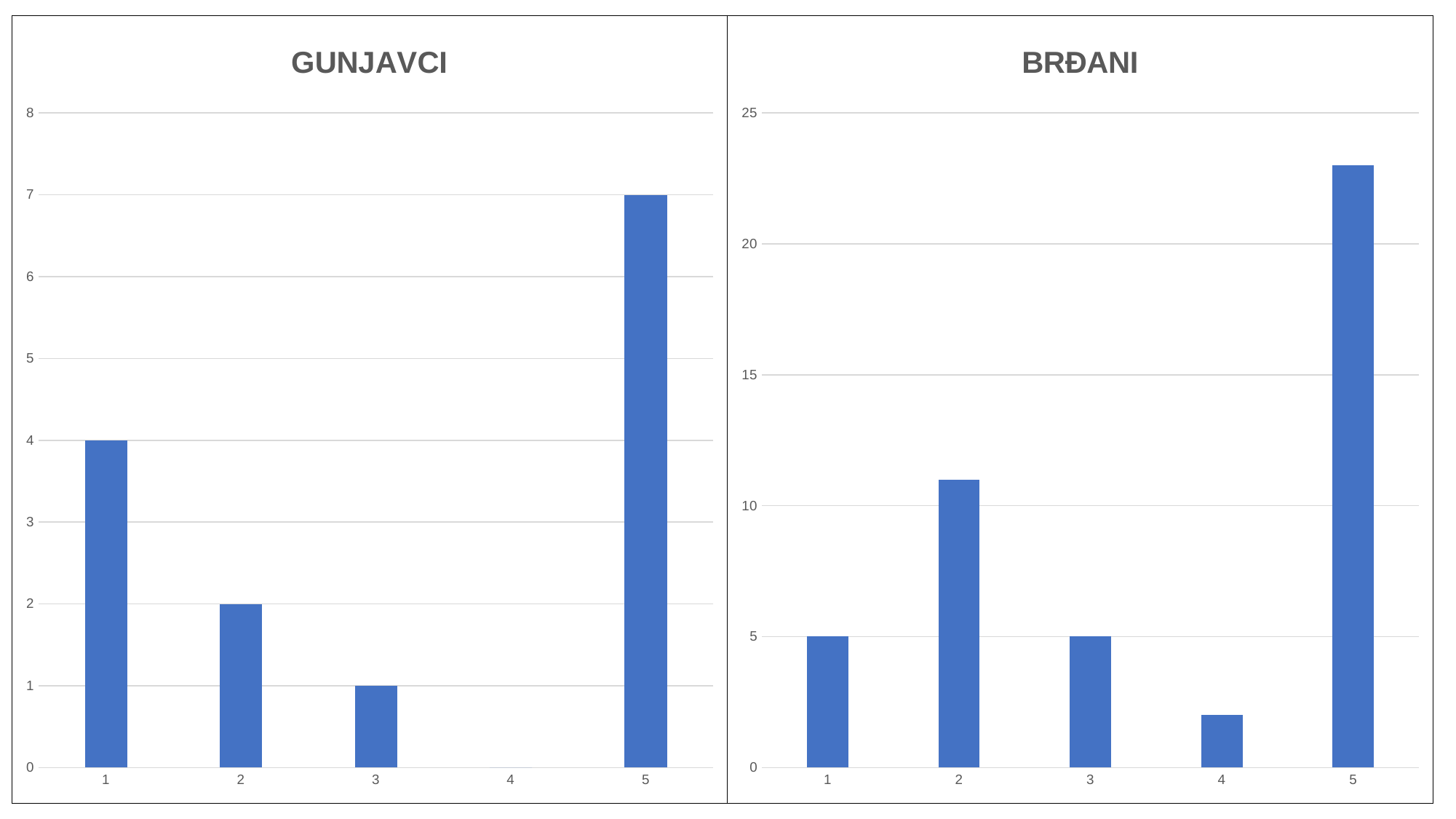
In the BRĐANI chart, what is the value for category 1? 5 In the GUNJAVCI chart, what is the value for category 5? 7 In the GUNJAVCI chart, which category has the highest value? 5 In the BRĐANI chart, which category has the highest value? 5 In the GUNJAVCI chart, which is larger, the value for category 1 or category 2? Category 1 In the GUNJAVCI chart, what is the difference between the values for category 5 and category 1? 3 What type of chart is the BRĐANI chart? Bar chart In the GUNJAVCI chart, what is the value for category 3? 1 In the BRĐANI chart, is the value for category 2 greater or less than 10? greater In the GUNJAVCI chart, what is the value for category 1? 4 In the BRĐANI chart, is the value for category 5 greater or less than 20? greater In the BRĐANI chart, which category has the lowest value? 4